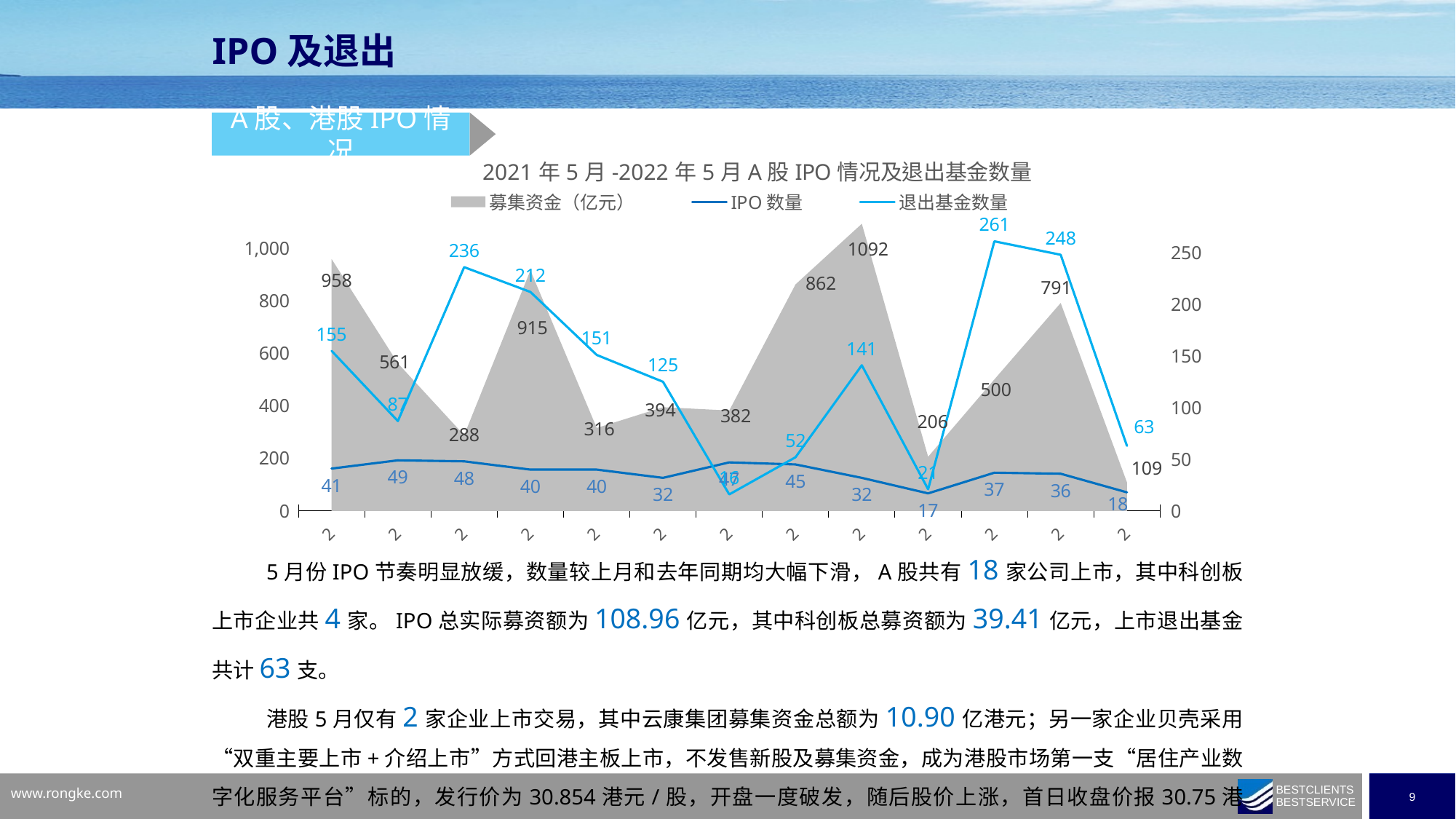
What is the IPO 数量 value at the last data point on the chart? 18 What is the lowest value of the IPO 数量 series? 17 What is the highest value of the 退出基金数量 series? 261 How many series does the chart legend list? 3 What is the highest value of the 募集资金（亿元） series? 1092 How many data points does each series in the chart have? 13 What is the lowest value of the 募集资金（亿元） series? 109 What is the title of the chart? 2021 年 5 月 -2022 年 5 月 A 股 IPO 情况及退出基金数量 Is the highest value of the 退出基金数量 series greater or less than 250? greater What is the highest value of the IPO 数量 series? 49 What kind of chart is shown on the slide? Combined area and line chart What is the difference between the highest and lowest values of the 募集资金（亿元） series? 983